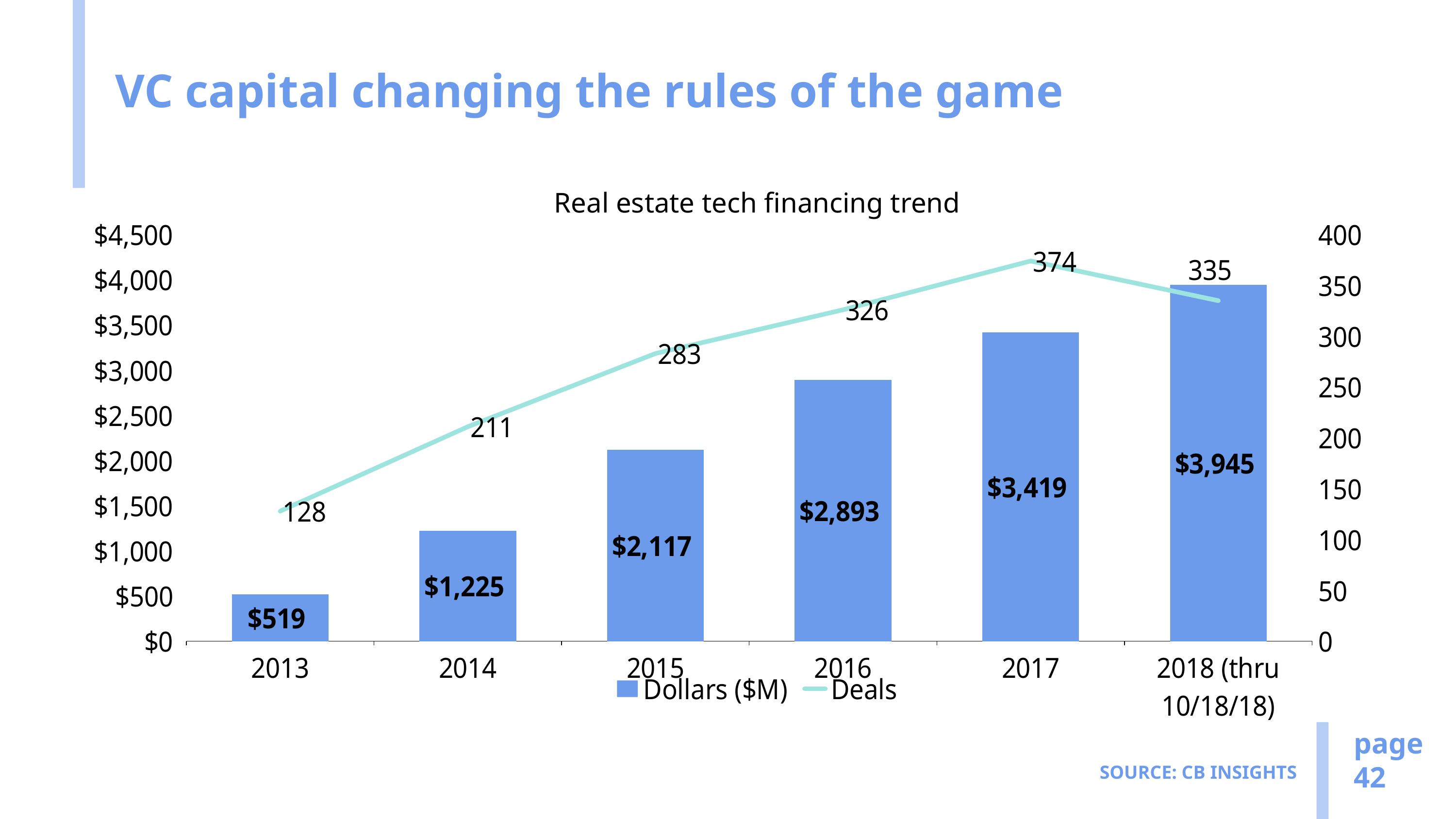
How many Deals were there in 2017? 374 Which year has the highest Dollars ($M) value? 2018 (thru 10/18/18) How many years are shown on the x axis? 6 Which year has the lowest number of Deals? 2013 How many more Deals were there in 2015 than in 2014? 72 What is the title of the chart? Real estate tech financing trend What is the Dollars ($M) value for 2018 (thru 10/18/18)? $3,945 What is the Dollars ($M) value for 2015? $2,117 Which year has the highest number of Deals? 2017 How many series does the legend list? 2 What is the difference in Dollars ($M) between 2017 and 2016? $526 Which is larger, the number of Deals in 2016 or in 2018 (thru 10/18/18)? 2018 (thru 10/18/18)